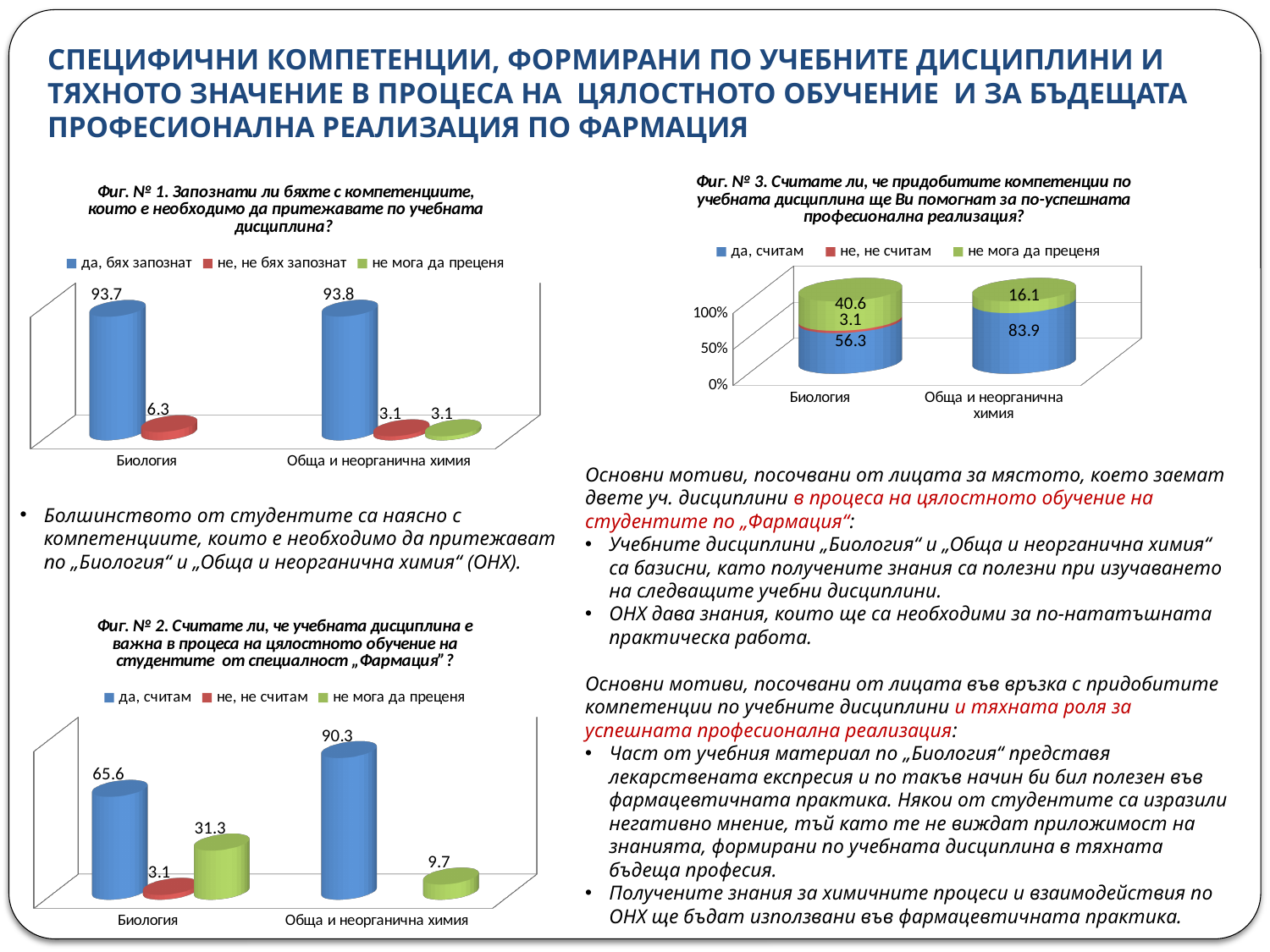
In Фиг. № 1, what is the value for "да, бях запознат" for Биология? 93.7 What kind of chart is Фиг. № 2? bar chart In Фиг. № 3, what is the value for "не мога да преценя" for Обща и неорганична химия? 16.1 In Фиг. № 3, what is the total of the stacked bar for Биология? 100 In Фиг. № 1, what is the value for "да, бях запознат" for Обща и неорганична химия? 93.8 In Фиг. № 1, how many series does the legend list? 3 In Фиг. № 2, which category has the higher "да, считам" value? Обща и неорганична химия In Фиг. № 2, what is the difference between the "да, считам" values for Обща и неорганична химия and Биология? 24.7 In Фиг. № 1, what is the value for "не, не бях запознат" for Биология? 6.3 In Фиг. № 3, what is the value for "да, считам" for Биология? 56.3 In Фиг. № 2, what is the value for "не мога да преценя" for Биология? 31.3 In Фиг. № 2, what is the value for "да, считам" for Обща и неорганична химия? 90.3